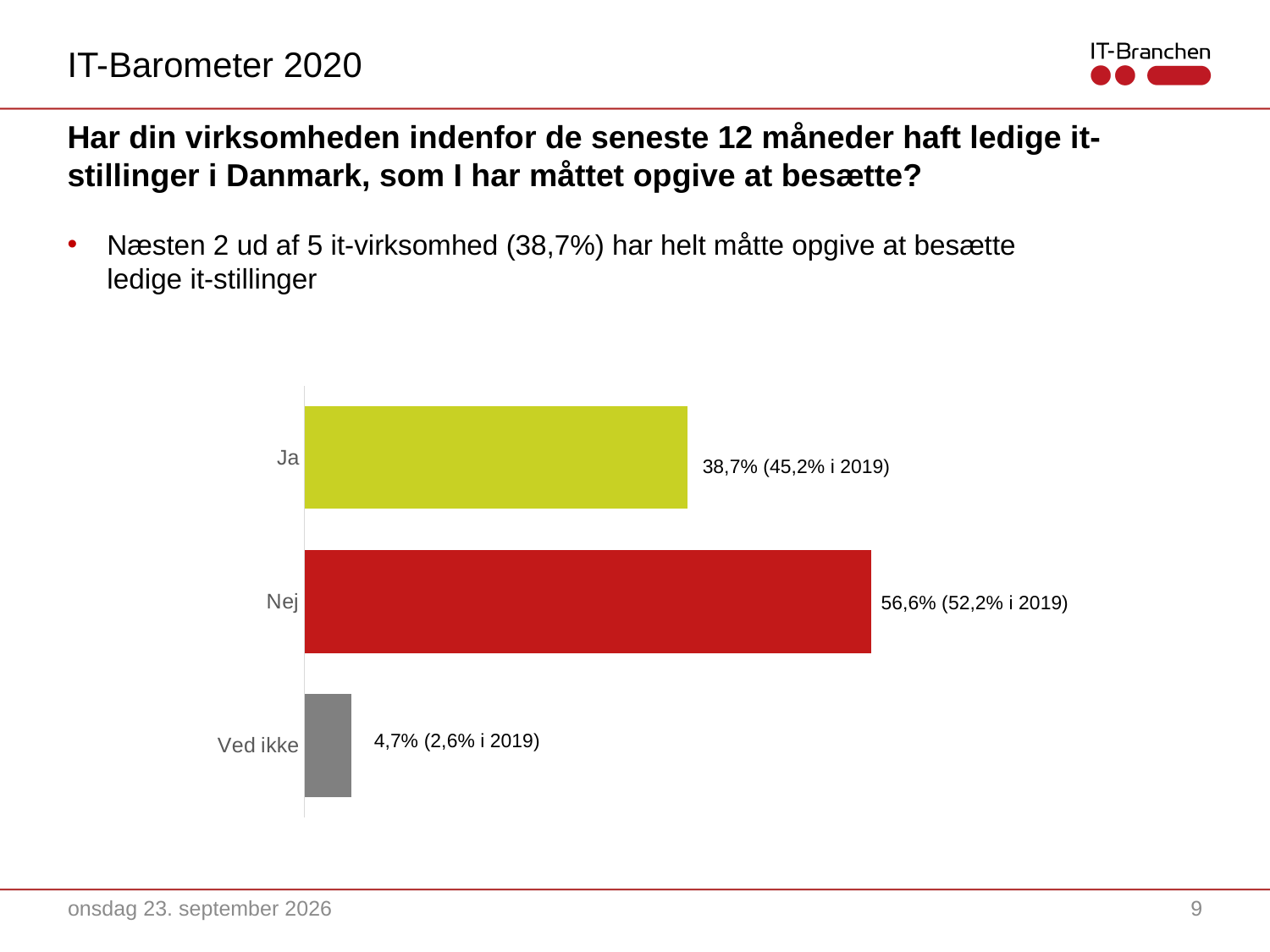
What is the value for Ved ikke? 4,7% What kind of chart is shown on the slide? Bar chart Which category has the lowest value? Ved ikke What was the 2019 value for Nej, as shown in the data label? 52,2% Which category has the highest value? Nej What is the value for Ja? 38,7% What is the value for Nej? 56,6% What is the difference between the values for Nej and Ja? 17,9% How many categories are shown in the chart? 3 What was the 2019 value for Ja, as shown in the data label? 45,2% Which is larger, the value for Ja or the value for Nej? Nej What was the 2019 value for Ved ikke, as shown in the data label? 2,6%